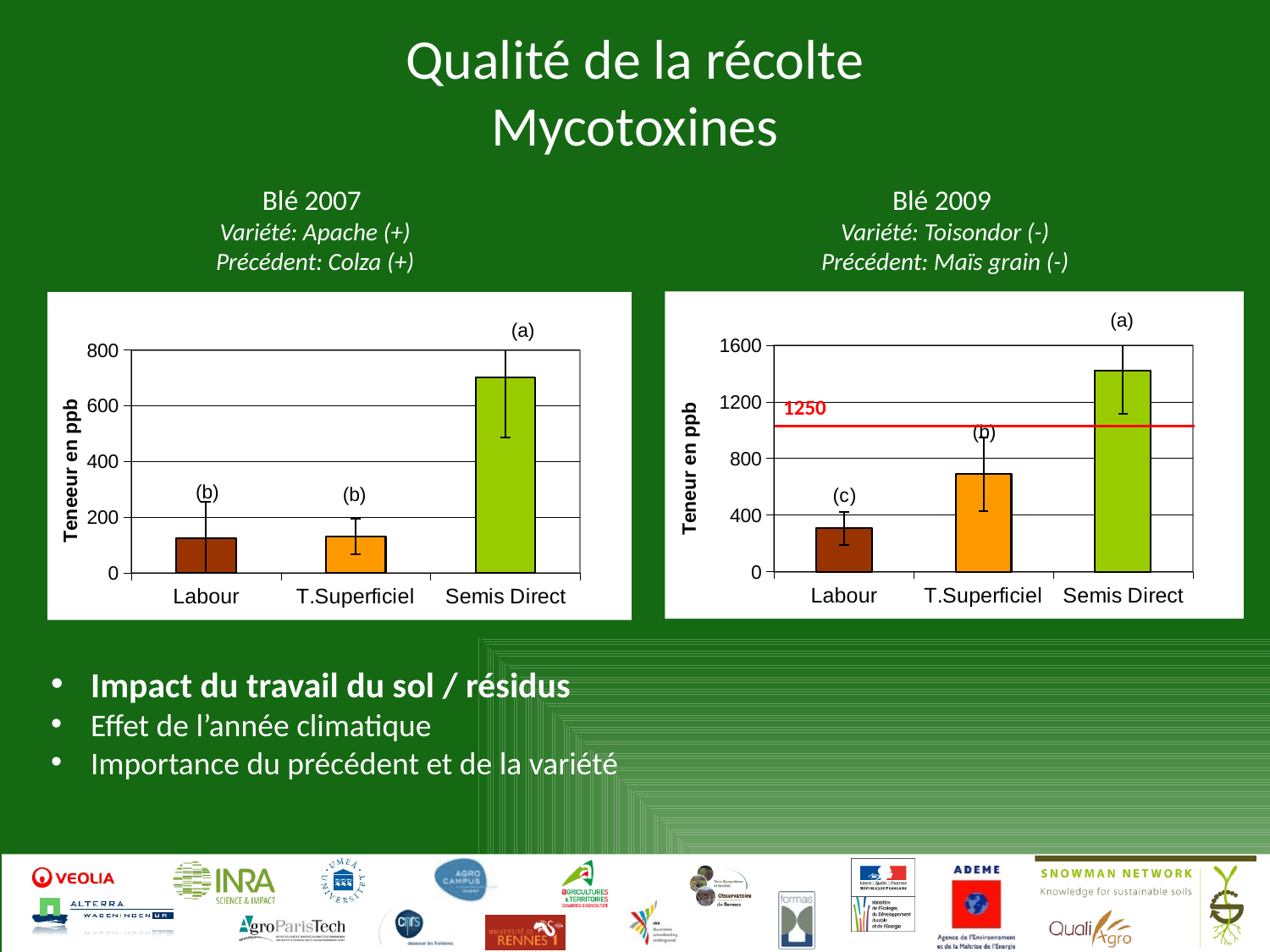
What value is written next to the red horizontal line in the Blé 2009 chart on the right? 1250 What is the y-axis title of the Blé 2009 chart on the right? Teneur en ppb How many categories are shown on the x axis of the Blé 2009 chart on the right? 3 What kind of chart is the Blé 2007 chart on the left? bar chart In the Blé 2009 chart on the right, which category has the lowest value? Labour In the Blé 2009 chart on the right, is the value for Semis Direct greater or less than 1200? greater In the Blé 2009 chart on the right, is the value for Labour greater or less than 400? less In the Blé 2007 chart on the left, is the value for Labour greater or less than 200? less In the Blé 2007 chart on the left, which category has the highest value? Semis Direct In the Blé 2009 chart on the right, which category has the highest value? Semis Direct In the Blé 2009 chart on the right, which is larger, the value for T.Superficiel or the value for Labour? T.Superficiel